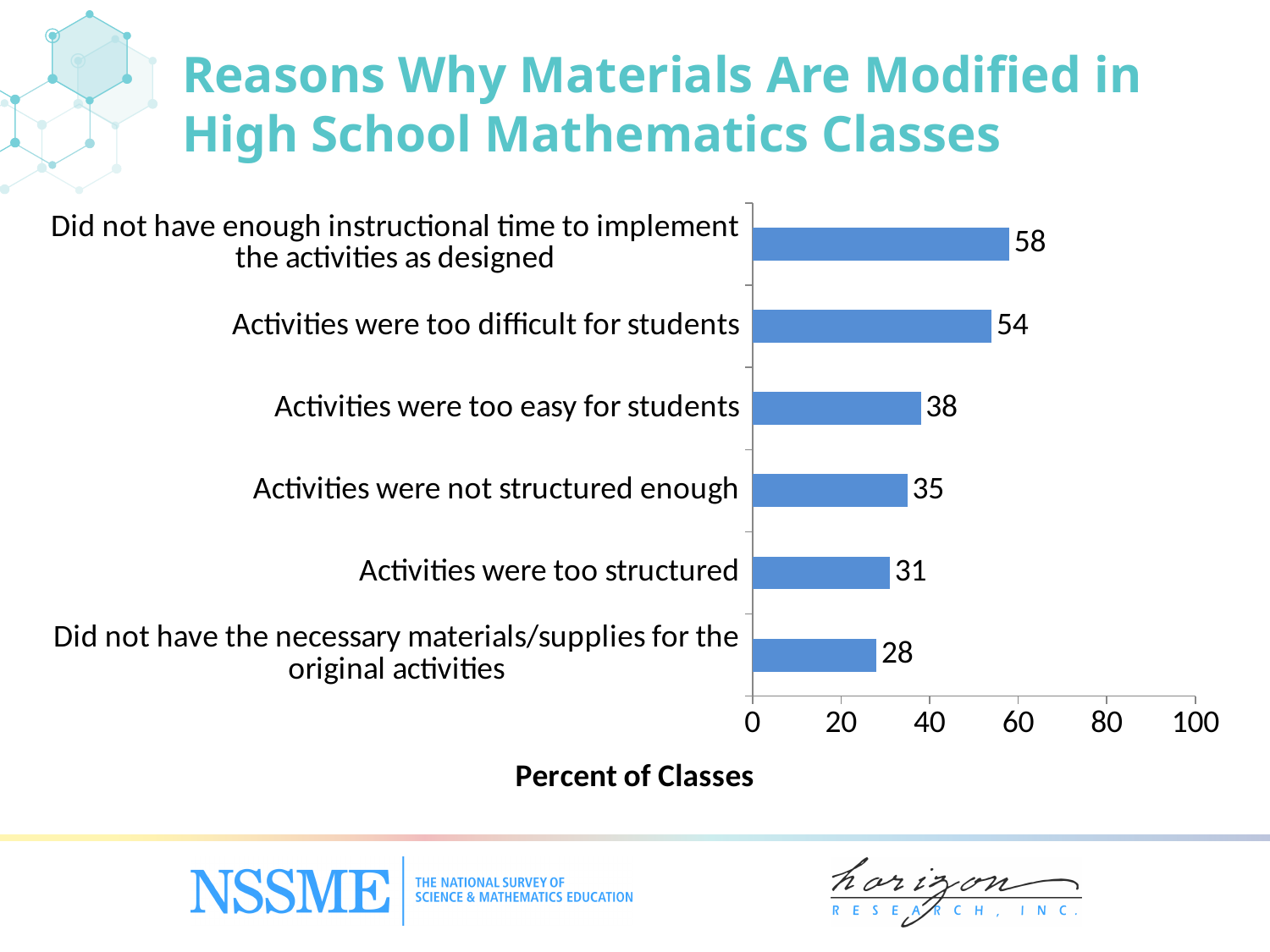
What is the value for 'Activities were too structured'? 31 What percent of classes did not have the necessary materials/supplies for the original activities? 28 How many reasons are shown in the chart? 6 Which reason has the highest percent of classes? Did not have enough instructional time to implement the activities as designed Which is larger: the value for 'Activities were too difficult for students' or 'Activities were too easy for students'? Activities were too difficult for students What percent of classes reported that activities were too difficult for students? 54 Which reason has the lowest percent of classes? Did not have the necessary materials/supplies for the original activities What is the label of the horizontal axis? Percent of Classes What is the maximum value shown on the horizontal axis? 100 Is the value for 'Activities were not structured enough' greater or less than 40? less What kind of chart is shown on the slide? Bar chart What is the difference between the values for 'Activities were too easy for students' and 'Activities were not structured enough'? 3